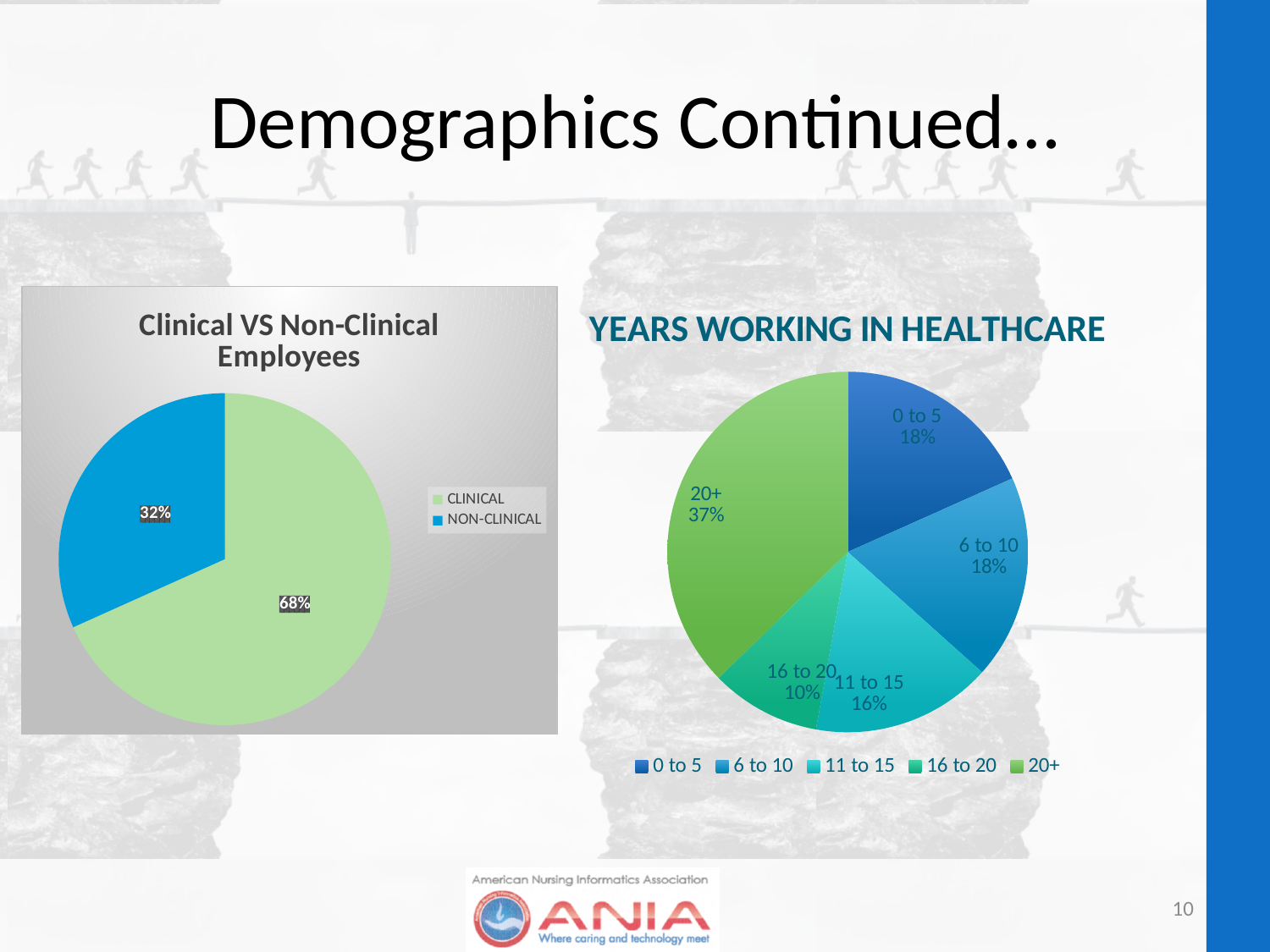
In the 'YEARS WORKING IN HEALTHCARE' chart, what is the difference in percentage points between the 20+ category and the 0 to 5 category? 19 In the 'YEARS WORKING IN HEALTHCARE' chart, which category has the largest share? 20+ In the 'YEARS WORKING IN HEALTHCARE' chart, what share of respondents have worked 11 to 15 years? 16% In the 'YEARS WORKING IN HEALTHCARE' chart, how many categories are shown? 5 In the 'Clinical VS Non-Clinical Employees' chart, what percentage of employees are non-clinical? 32% In the 'Clinical VS Non-Clinical Employees' chart, what percentage of employees are clinical? 68% In the 'YEARS WORKING IN HEALTHCARE' chart, which category has the smallest share? 16 to 20 What kind of chart is the 'Clinical VS Non-Clinical Employees' chart? Pie chart In the 'YEARS WORKING IN HEALTHCARE' chart, which is larger: the share for 11 to 15 years or the share for 16 to 20 years? 11 to 15 In the 'YEARS WORKING IN HEALTHCARE' chart, what share of respondents have worked 20+ years? 37% How many entries does the legend of the 'Clinical VS Non-Clinical Employees' chart list? 2 In the 'Clinical VS Non-Clinical Employees' chart, what is the difference in percentage points between clinical and non-clinical employees? 36